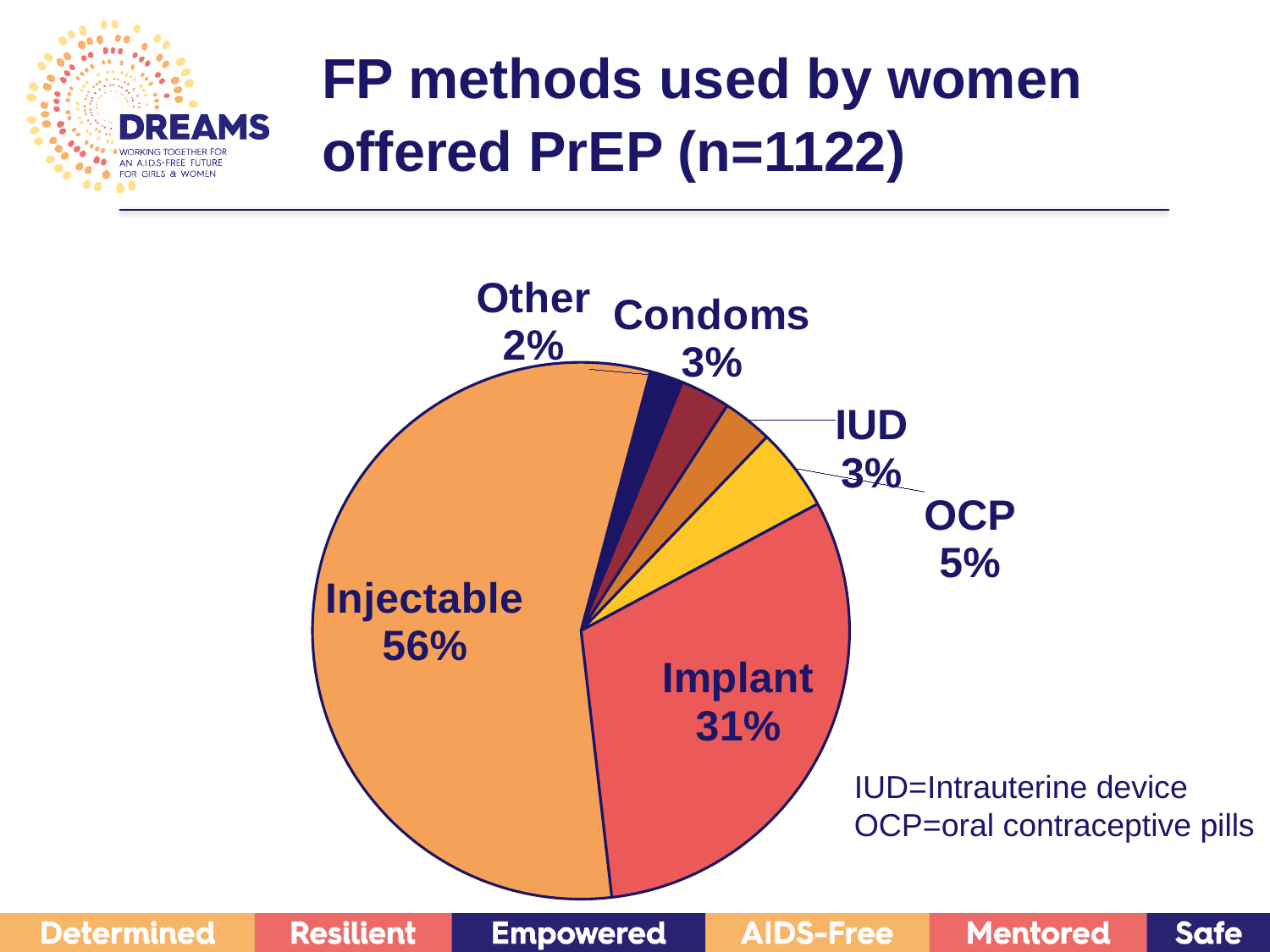
Which is larger, the share for OCP or the share for Condoms? OCP What is the value shown for OCP? 5% What kind of chart is shown on the slide? Pie chart What is the value shown for Other? 2% How many slices does the pie chart have? 6 According to the note on the slide, what does OCP stand for? Oral contraceptive pills What is the difference in percentage points between Injectable and Implant? 25 Which FP method has the smallest slice of the pie? Other Which FP method has the largest slice of the pie? Injectable What share of the pie does Injectable account for? 56% What is the value shown for Implant? 31% What is the title of the chart? FP methods used by women offered PrEP (n=1122)